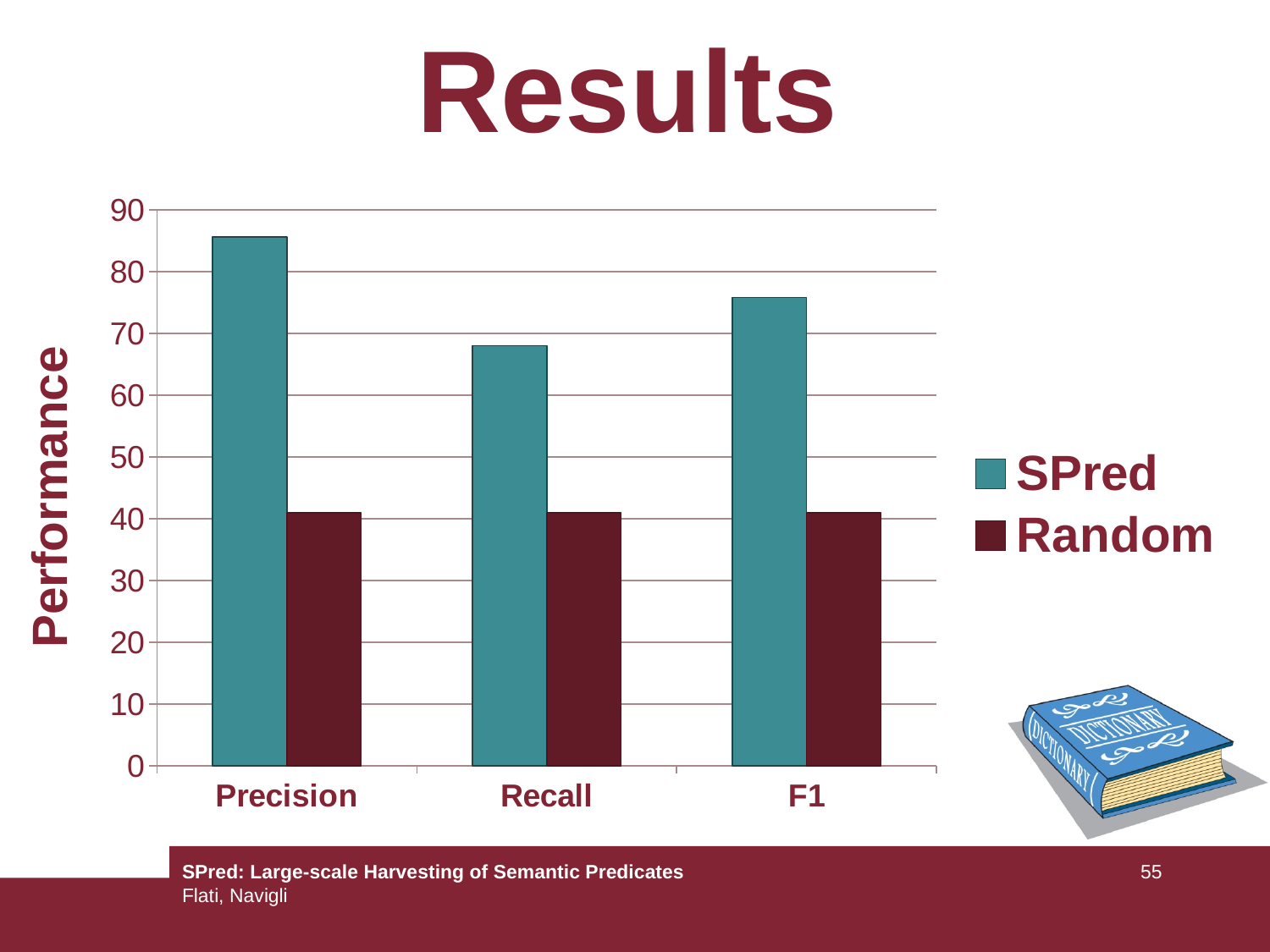
Which category has the lowest SPred value? Recall Which series is shown in teal? SPred Is the SPred value for Precision greater or less than 80? greater For Recall, which series has the larger value, SPred or Random? SPred Is the SPred value for Recall greater or less than 70? less Is the SPred value for F1 greater or less than 70? greater How many series does the legend list? 2 Which category has the highest SPred value? Precision What is the label of the y axis? Performance How many categories are shown on the x axis? 3 What kind of chart is shown on the slide? bar chart